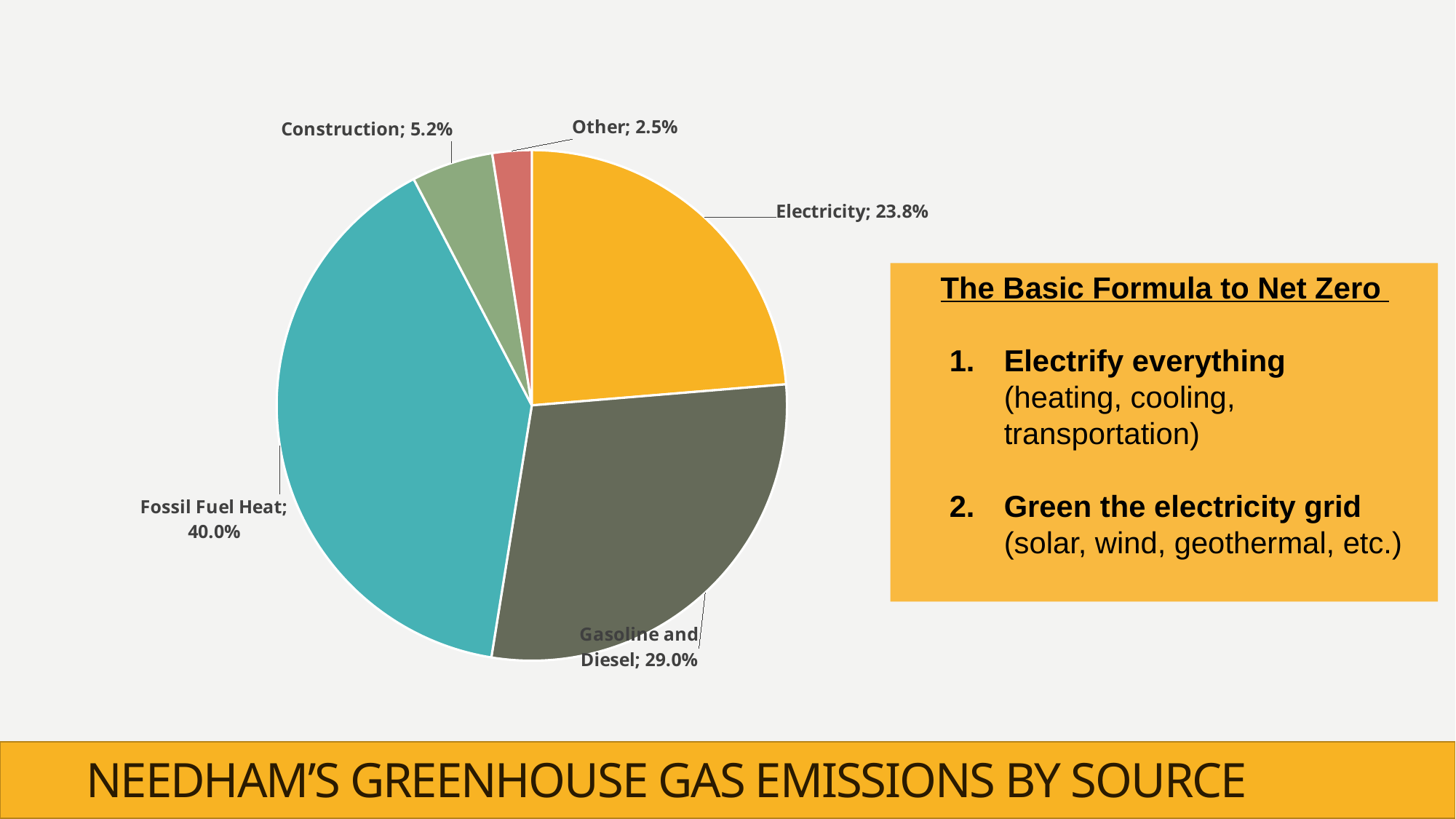
What share of emissions comes from Gasoline and Diesel? 29.0% What kind of chart is shown on the slide? pie chart Which source accounts for the smallest share of emissions? Other How many sources (slices) does the pie chart show? 5 What is the title shown at the bottom of the slide for this chart? NEEDHAM'S GREENHOUSE GAS EMISSIONS BY SOURCE Which is larger, the share for Electricity or the share for Gasoline and Diesel? Gasoline and Diesel What share of emissions comes from Construction? 5.2% Which source accounts for the largest share of emissions? Fossil Fuel Heat What share of emissions comes from Electricity? 23.8% What share of emissions is labelled Other? 2.5% What share of Needham's greenhouse gas emissions comes from Fossil Fuel Heat? 40.0% What is the difference in percentage points between Fossil Fuel Heat and Gasoline and Diesel? 11.0 percentage points